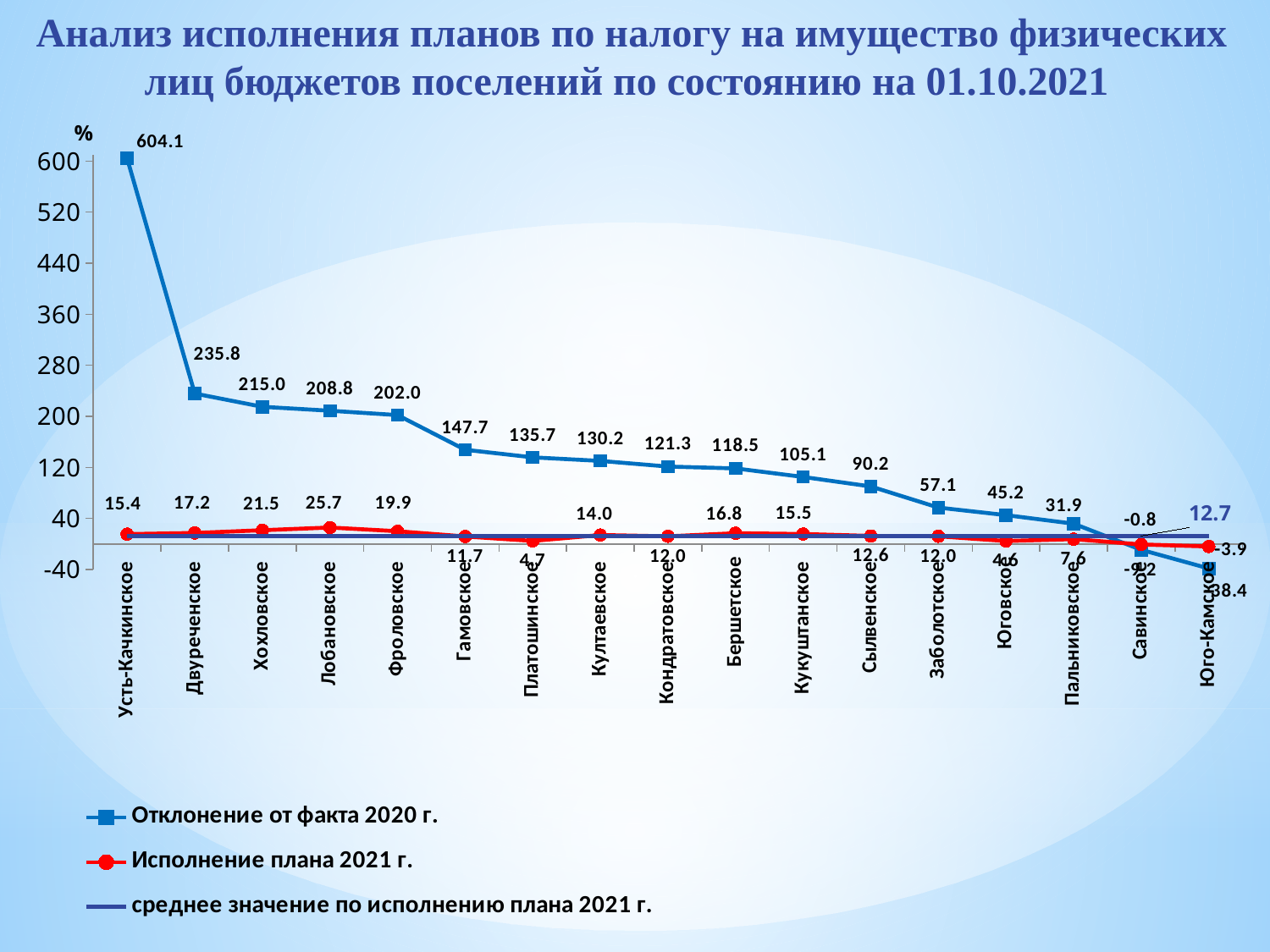
What is the value of "Отклонение от факта 2020 г." for Усть-Качкинское? 604.1 How many settlements are shown on the x axis? 17 What kind of chart is shown on the slide? Line chart Does the "Отклонение от факта 2020 г." series rise or fall from left to right along the x axis? Fall Which settlement has the lowest value for "Отклонение от факта 2020 г."? Юго-Камское What is the value of "Исполнение плана 2021 г." for Лобановское? 25.7 What is the difference between the "Отклонение от факта 2020 г." values for Двуреченское and Хохловское? 20.8 What is the value of "Отклонение от факта 2020 г." for Сылвенское? 90.2 Which settlement has the highest value for "Исполнение плана 2021 г."? Лобановское Which settlement has the highest value for "Отклонение от факта 2020 г."? Усть-Качкинское Which has the larger "Исполнение плана 2021 г." value, Хохловское or Фроловское? Хохловское How many series does the legend list? 3